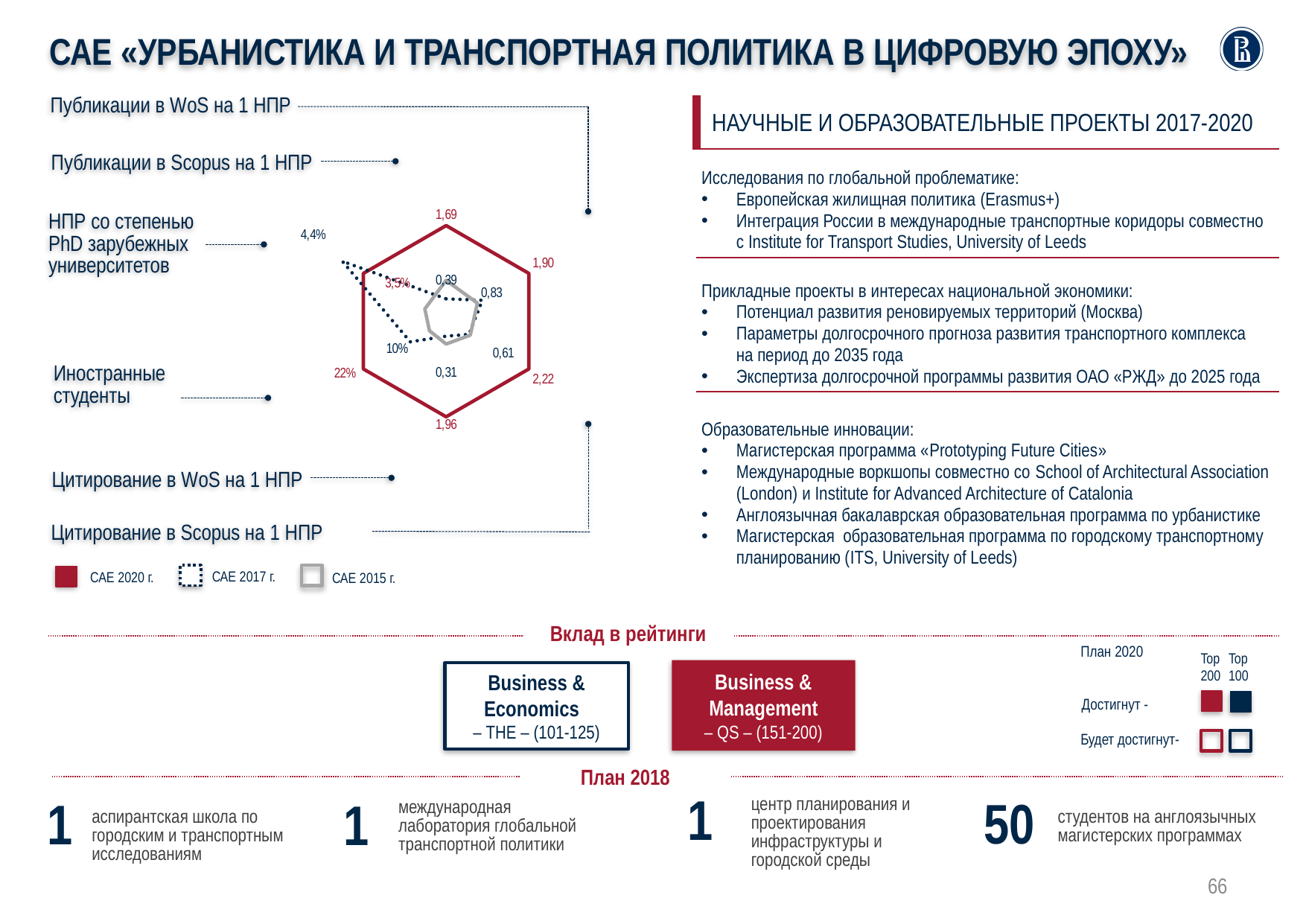
What is the САЕ 2020 value for Иностранные студенты on the radar chart? 22% What type of chart is shown on the left of the slide? radar chart On the radar chart, which САЕ 2020 percentage is larger: Иностранные студенты or НПР со степенью PhD зарубежных университетов? Иностранные студенты What is the САЕ 2020 value for Публикации в WoS на 1 НПР on the radar chart? 1,90 What colour is used for the САЕ 2020 г. series on the radar chart? red How many series does the legend of the radar chart list? 3 On the radar chart, what is the difference between the САЕ 2020 values for Цитирование в Scopus на 1 НПР (2,22) and Цитирование в WoS на 1 НПР (1,96)? 0,26 What is the САЕ 2020 value for Цитирование в Scopus на 1 НПР on the radar chart? 2,22 How many axes (indicators) does the radar chart have? 6 Which series are listed in the legend of the radar chart? САЕ 2020 г., САЕ 2017 г., САЕ 2015 г. What is the САЕ 2020 value for НПР со степенью PhD зарубежных университетов on the radar chart? 3,5%